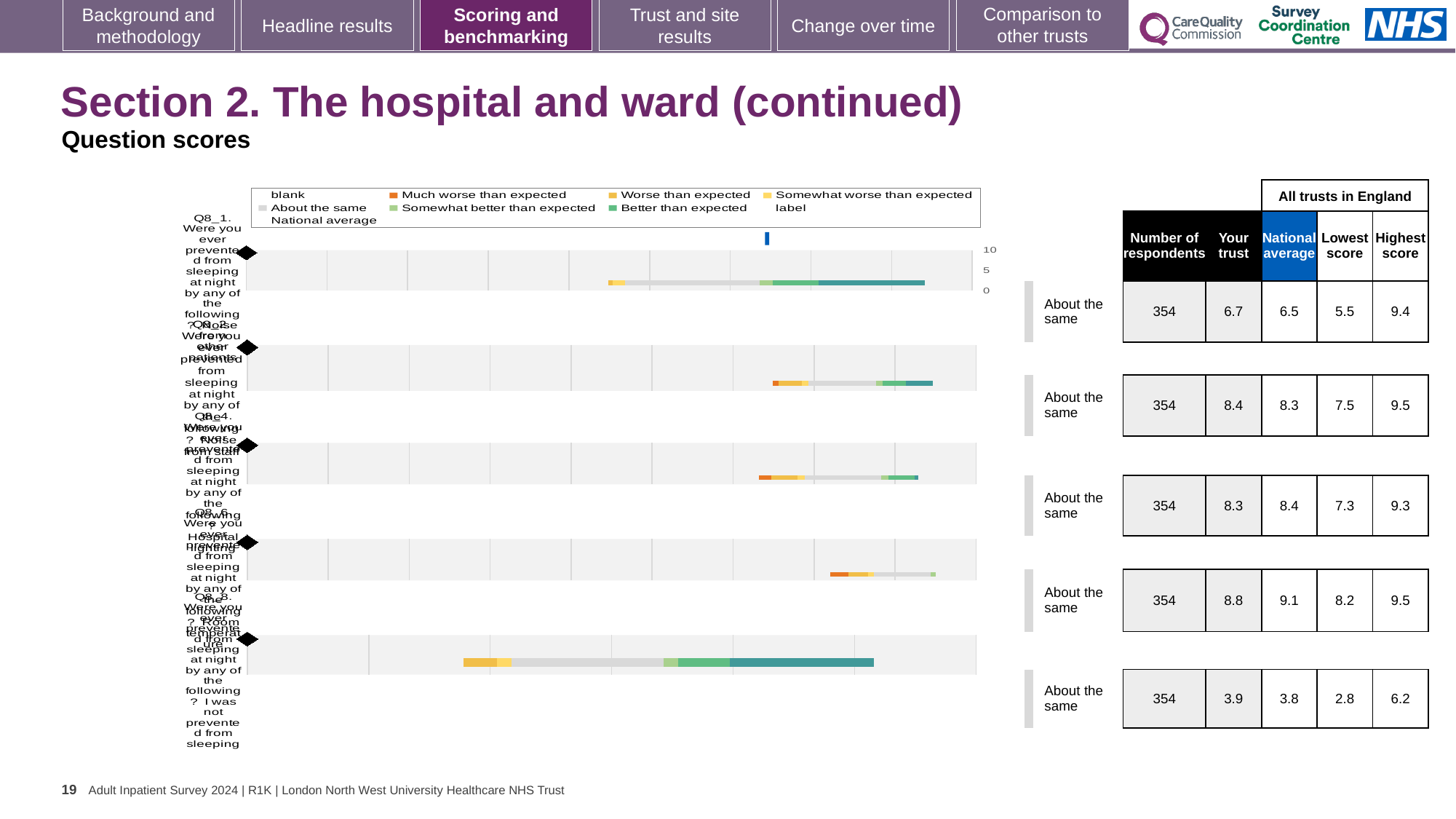
What is the national average for the last (bottom) question row? 3.8 Which question row has the highest 'Your trust' score? the fourth row, 8.8 What is the lowest score across all trusts in England for the bottom question row? 2.8 What is the number of respondents shown for the first (top) question row? 354 What is the highest score across all trusts in England for the second question row? 9.5 What benchmark category is shown next to every bar in the chart? About the same Which question row has the lowest 'Your trust' score? the last (bottom) row, 3.9 What kind of chart is shown on the slide? bar chart What is the 'Your trust' score for the first (top) question row? 6.7 For the fourth question row, is the 'Your trust' score (8.8) larger or smaller than the national average (9.1)? smaller How many question rows (bars) are plotted in the chart? 5 What is the difference between the highest score (9.4) and the lowest score (5.5) for the first question row? 3.9